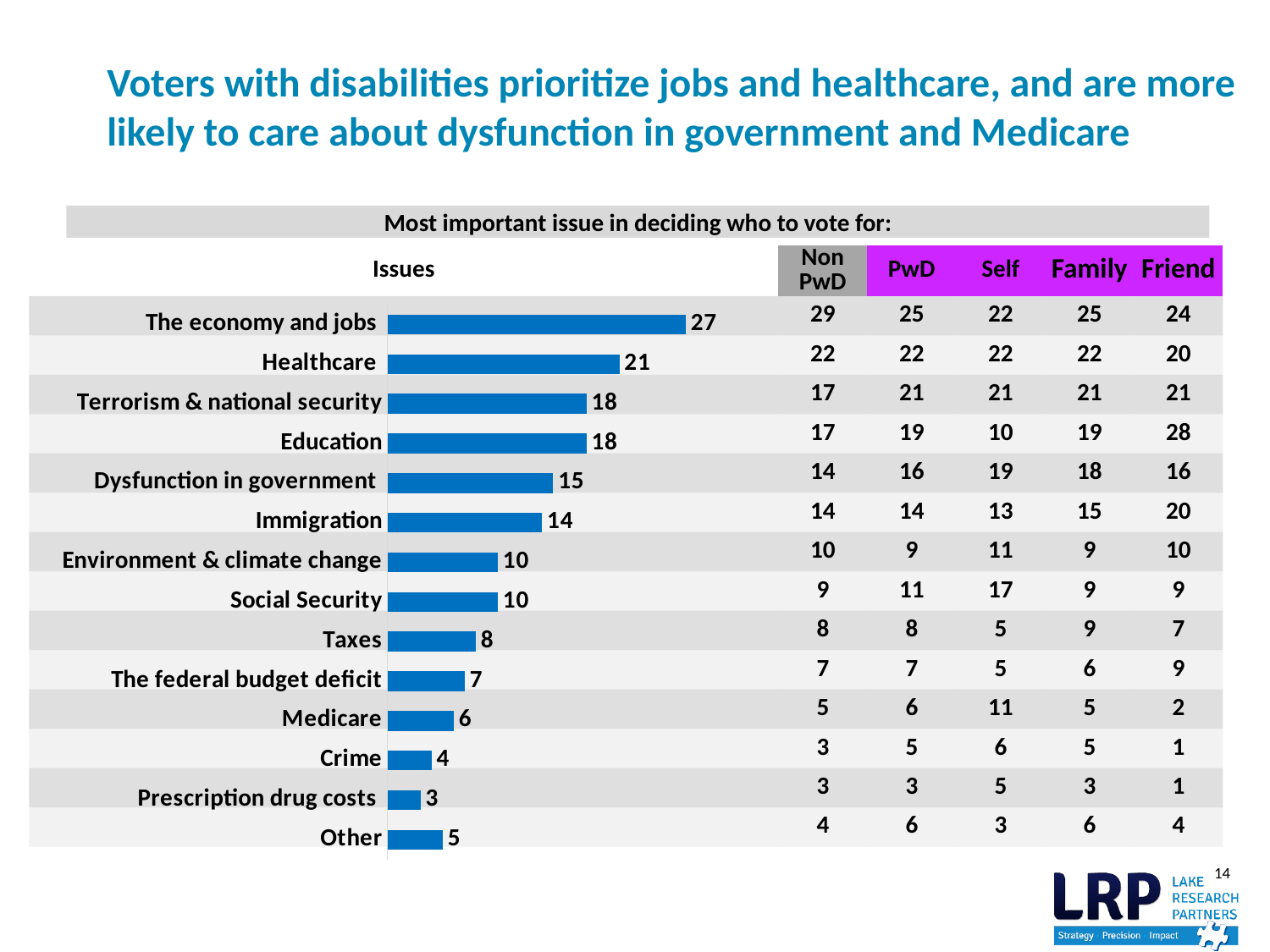
What is the difference between the bar values for The economy and jobs and Healthcare? 6 What is the difference between the bar values for Immigration and Taxes? 6 What is the heading above the bar chart? Most important issue in deciding who to vote for: What is the value shown for Other in the bar chart? 5 How many issues are plotted in the bar chart? 14 In the bar chart, which has the larger value, Healthcare or Terrorism & national security? Healthcare What is the value shown for Medicare in the bar chart? 6 What is the value shown for The economy and jobs in the bar chart? 27 What is the value shown for Dysfunction in government in the bar chart? 15 What kind of chart is used to show the issue values? Bar chart Which issue has the lowest value in the bar chart? Prescription drug costs Which issue has the highest value in the bar chart? The economy and jobs